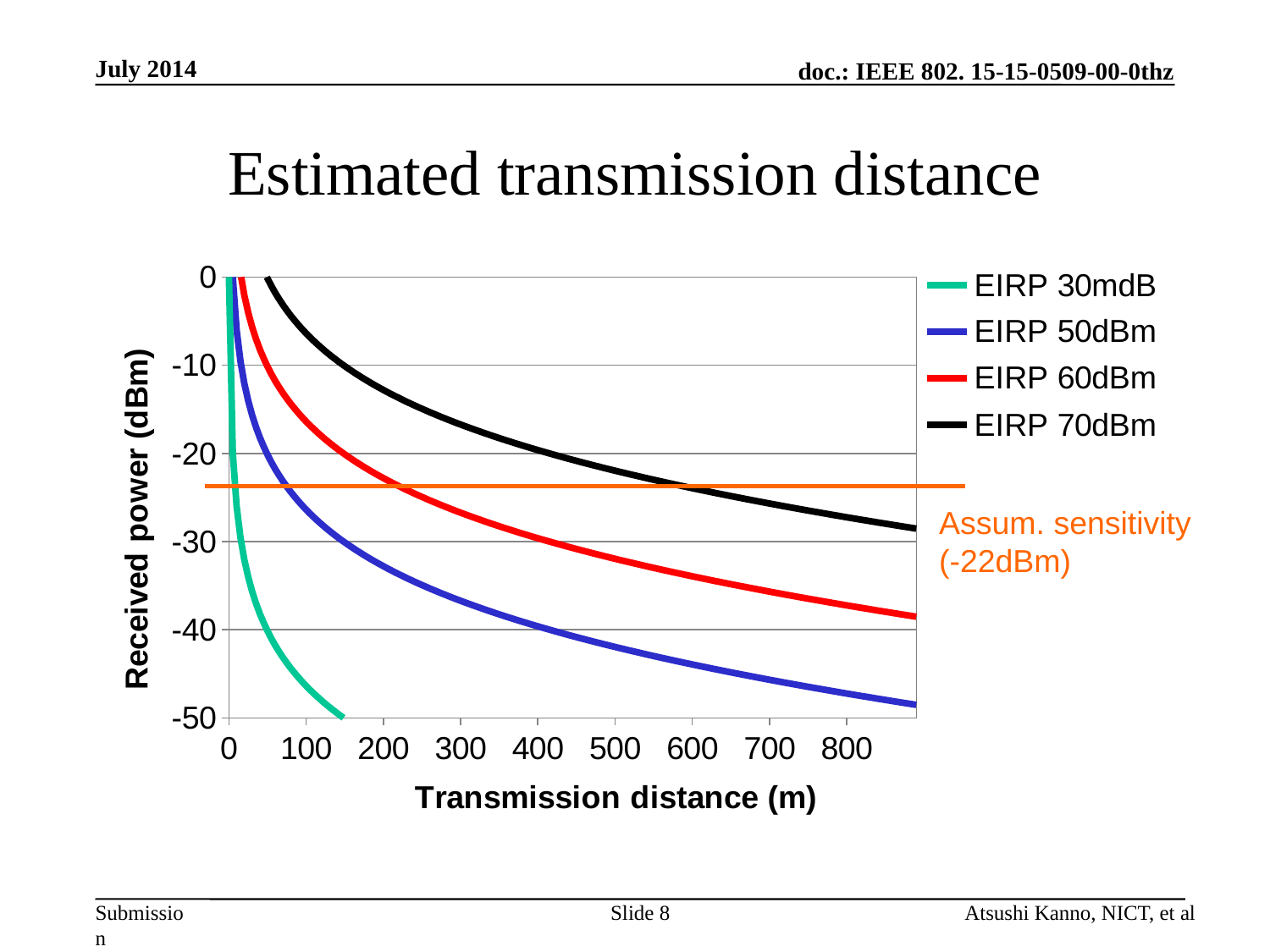
Do the received power values rise or fall as transmission distance increases? Fall Is the received power for EIRP 30mdB at 100 m greater or less than -40 dBm? less Which series has the lowest received power at a transmission distance of 100 m? EIRP 30mdB At 300 m, which series has the higher received power, EIRP 60dBm or EIRP 50dBm? EIRP 60dBm Is the received power for EIRP 60dBm at 800 m greater or less than -40 dBm? greater What is the assumed sensitivity marked by the orange horizontal line? -22dBm What is the title of the chart? Estimated transmission distance Which series has the highest received power at a transmission distance of 500 m? EIRP 70dBm Is the received power for EIRP 70dBm at 800 m greater or less than -20 dBm? less How many series does the legend list? 4 What kind of chart is shown on the slide? Line chart